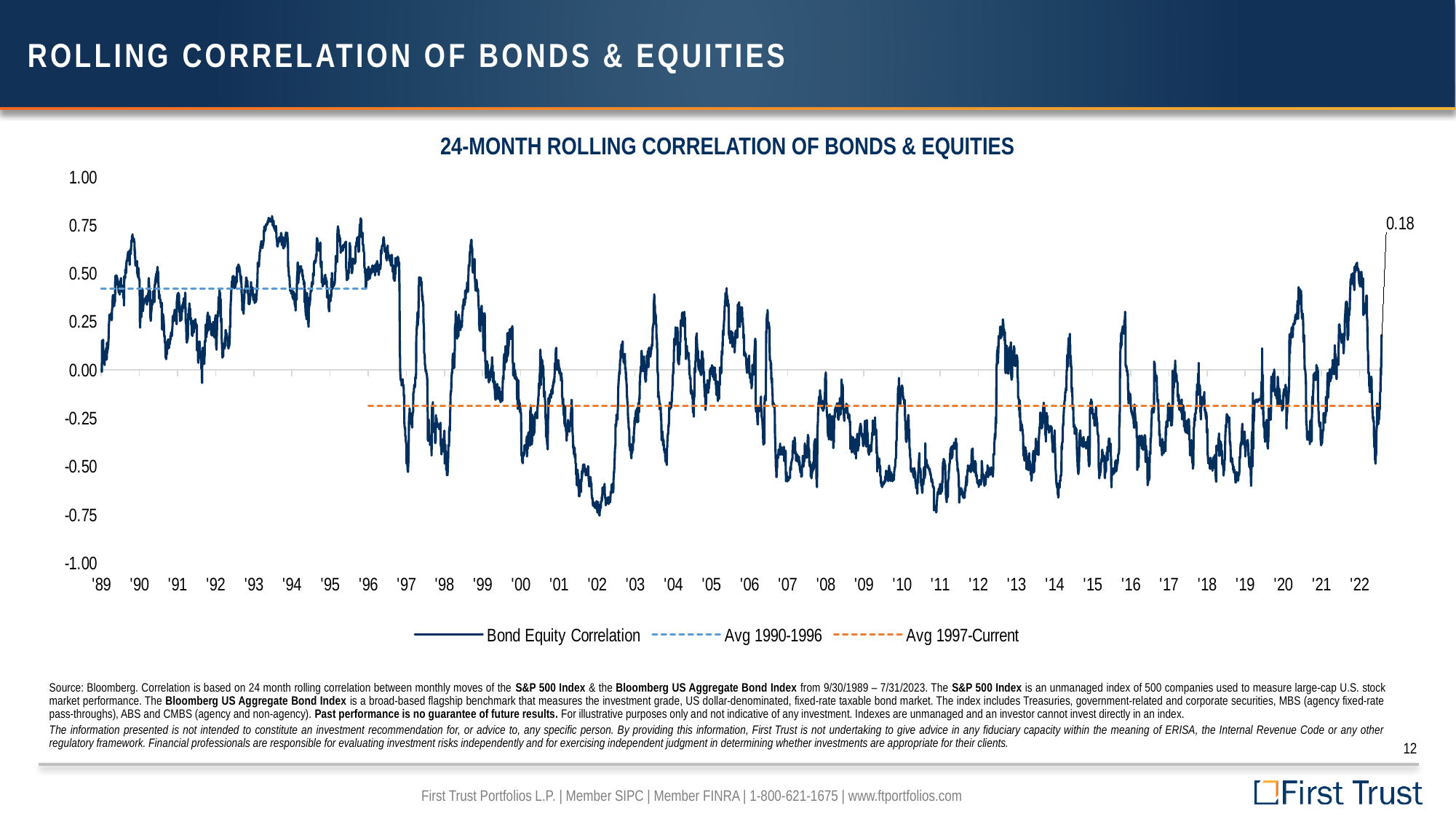
How many year labels are shown on the x axis? 34 Is the Avg 1997-Current line greater or less than 0.00? less What is the title of the chart? 24-MONTH ROLLING CORRELATION OF BONDS & EQUITIES What is the most recent value of the Bond Equity Correlation labelled at the right end of the line? 0.18 How many series does the legend list? 3 Is the peak of the Bond Equity Correlation around '93 greater or less than 0.50? greater Is the lowest point of the Bond Equity Correlation around '02 greater or less than -0.50? less Which is higher, the Avg 1990-1996 line or the Avg 1997-Current line? Avg 1990-1996 Does the Bond Equity Correlation rise or fall between '96 and '97? fall What kind of chart is shown on the slide? line chart What is the first year label on the x axis? '89